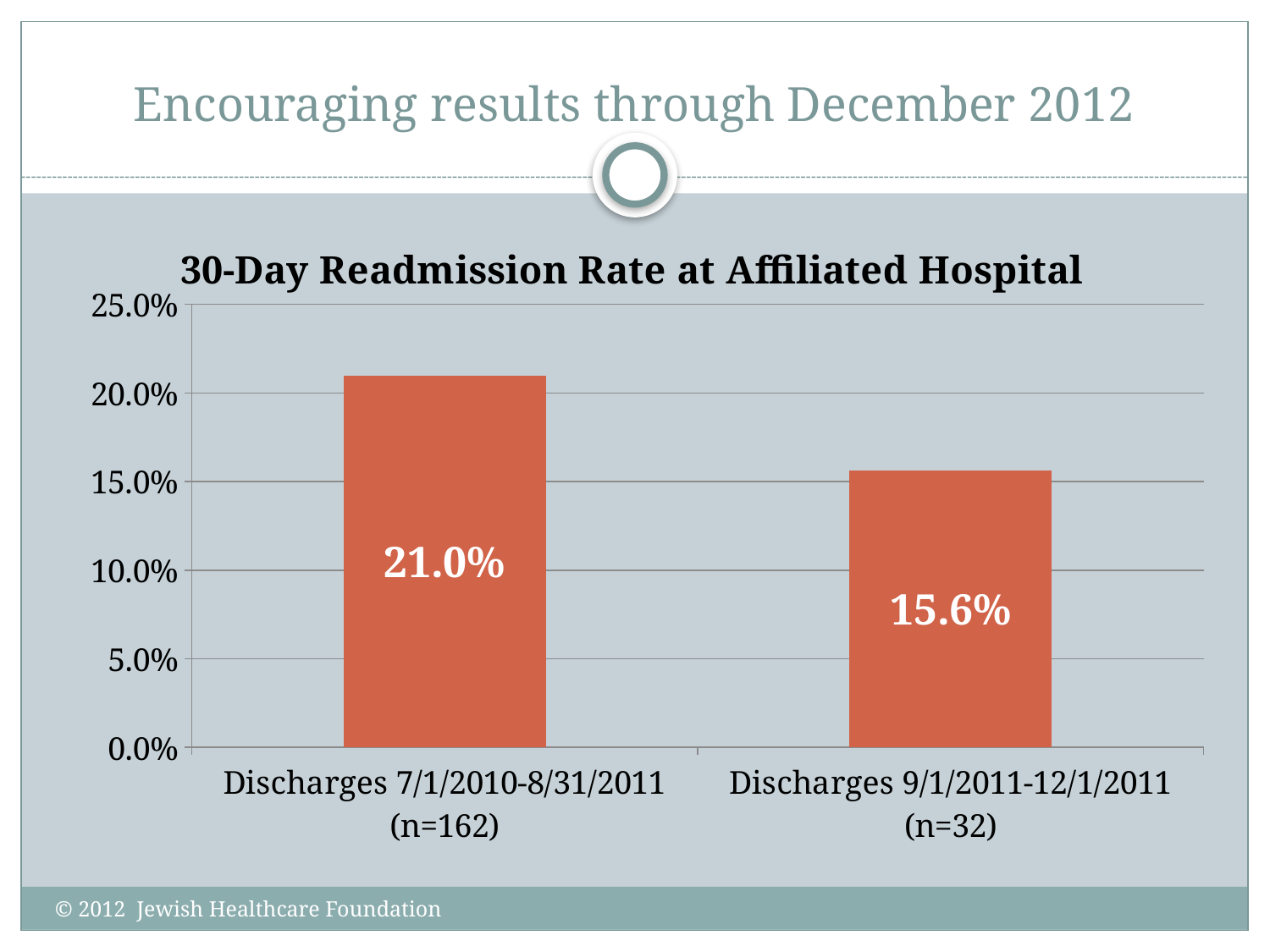
Which discharge period has the lower 30-day readmission rate? Discharges 9/1/2011-12/1/2011 (n=32) What is the 30-day readmission rate for Discharges 7/1/2010-8/31/2011 (n=162)? 21.0% What type of chart is shown on the slide? Bar chart How many discharge periods are shown in the chart? 2 What is the 30-day readmission rate for Discharges 9/1/2011-12/1/2011 (n=32)? 15.6% What is the maximum value shown on the chart's vertical axis? 25.0% Does the readmission rate rise or fall from the earlier discharge period to the later one? Fall Which discharge period has the higher 30-day readmission rate? Discharges 7/1/2010-8/31/2011 (n=162) What is the title of the chart? 30-Day Readmission Rate at Affiliated Hospital Is the readmission rate for Discharges 7/1/2010-8/31/2011 greater or less than 20.0%? greater Is the readmission rate for Discharges 9/1/2011-12/1/2011 greater or less than 20.0%? less What is the difference in readmission rate between the 7/1/2010-8/31/2011 period and the 9/1/2011-12/1/2011 period? 5.4%